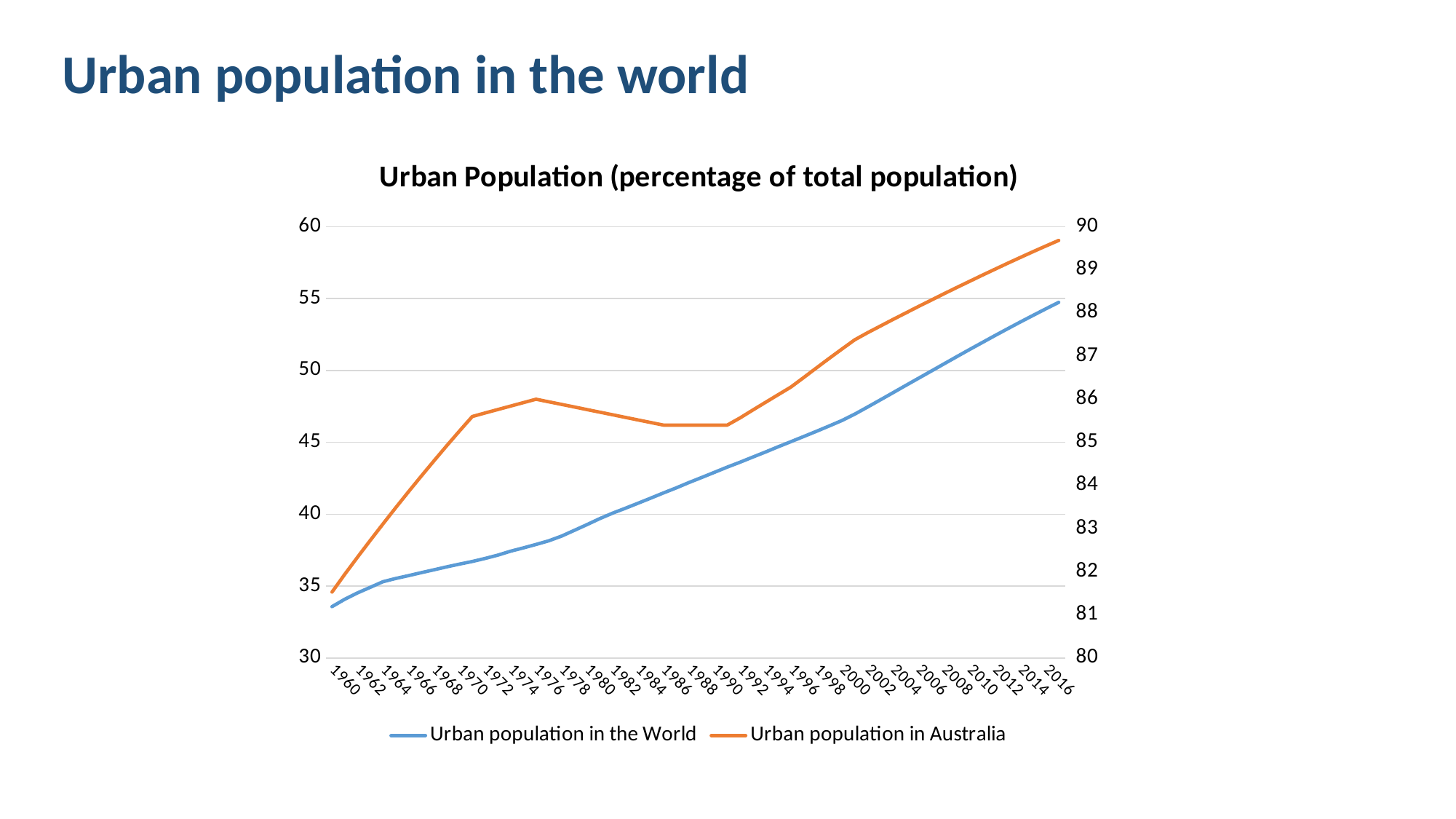
For 'Urban population in Australia', is the value in 1976 or in 1990 larger? 1976 Is the value for 'Urban population in Australia' in 1960 greater or less than 82 on the right axis? less How many series does the legend list? 2 Is the value for 'Urban population in the World' in 1960 greater or less than 35 on the left axis? less What is the title of the chart? Urban Population (percentage of total population) Is the value for 'Urban population in the World' in 2016 greater or less than 50 on the left axis? greater What kind of chart is shown on the slide? Line chart How many years are labelled along the x axis? 29 Which colour is used for the 'Urban population in Australia' line? Orange Does the 'Urban population in the World' line rise or fall from 1960 to 2016? Rises